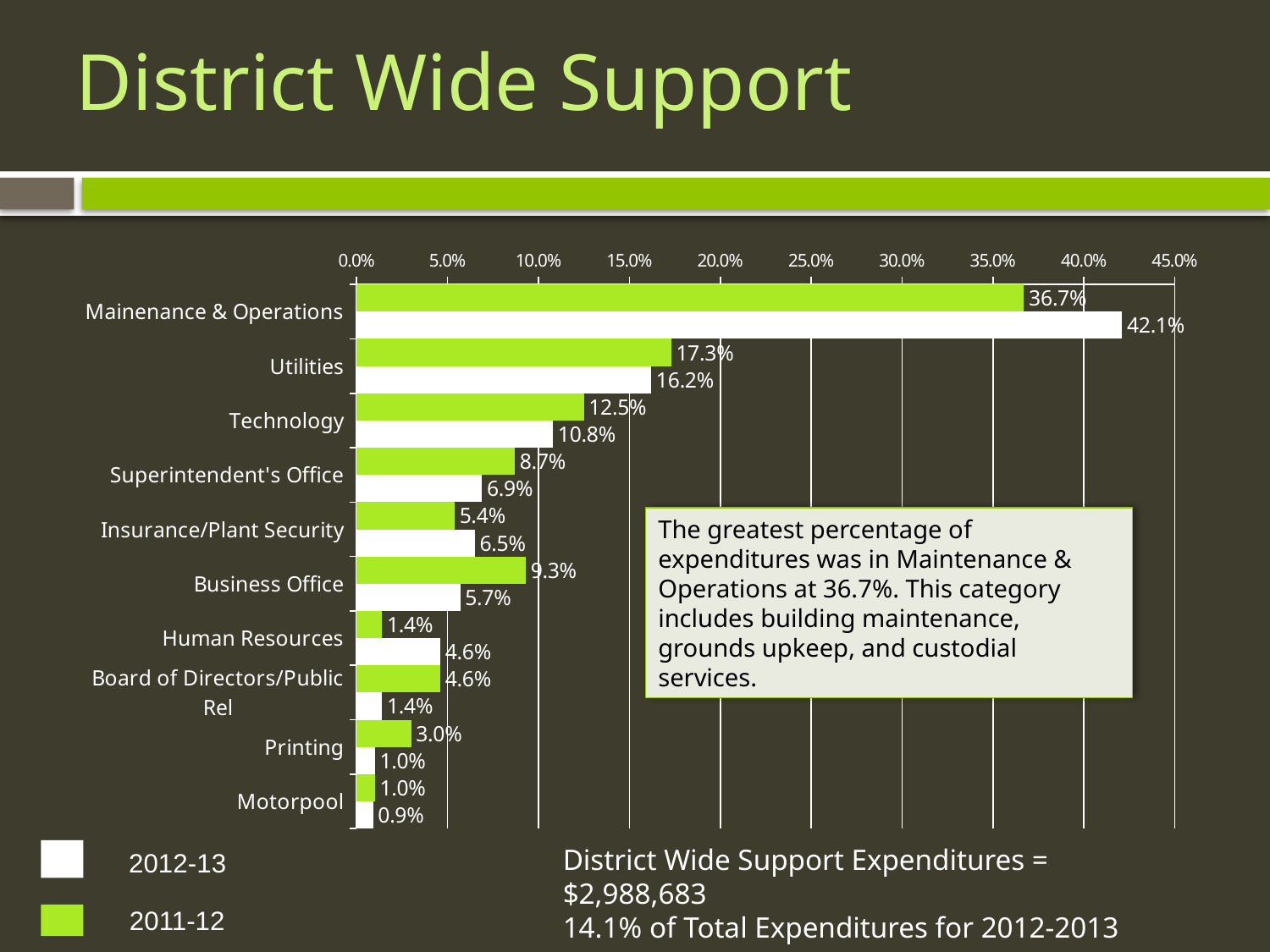
Which colour represents the 2011-12 series in the legend? green What type of chart is shown on the slide? bar chart Which category has the lowest 2012-13 value? Motorpool What is the 2012-13 value for Technology? 10.8% What is the 2012-13 value for Mainenance & Operations? 42.1% How many series does the legend list? 2 Which category has the highest 2012-13 value? Mainenance & Operations How many categories are shown on the chart? 10 What is the 2011-12 value for Utilities? 17.3% What is the difference between the 2012-13 and 2011-12 values for Mainenance & Operations? 5.4% Is the 2012-13 value for Utilities greater or less than 15.0%? greater Which is larger for Business Office, the 2011-12 value or the 2012-13 value? 2011-12